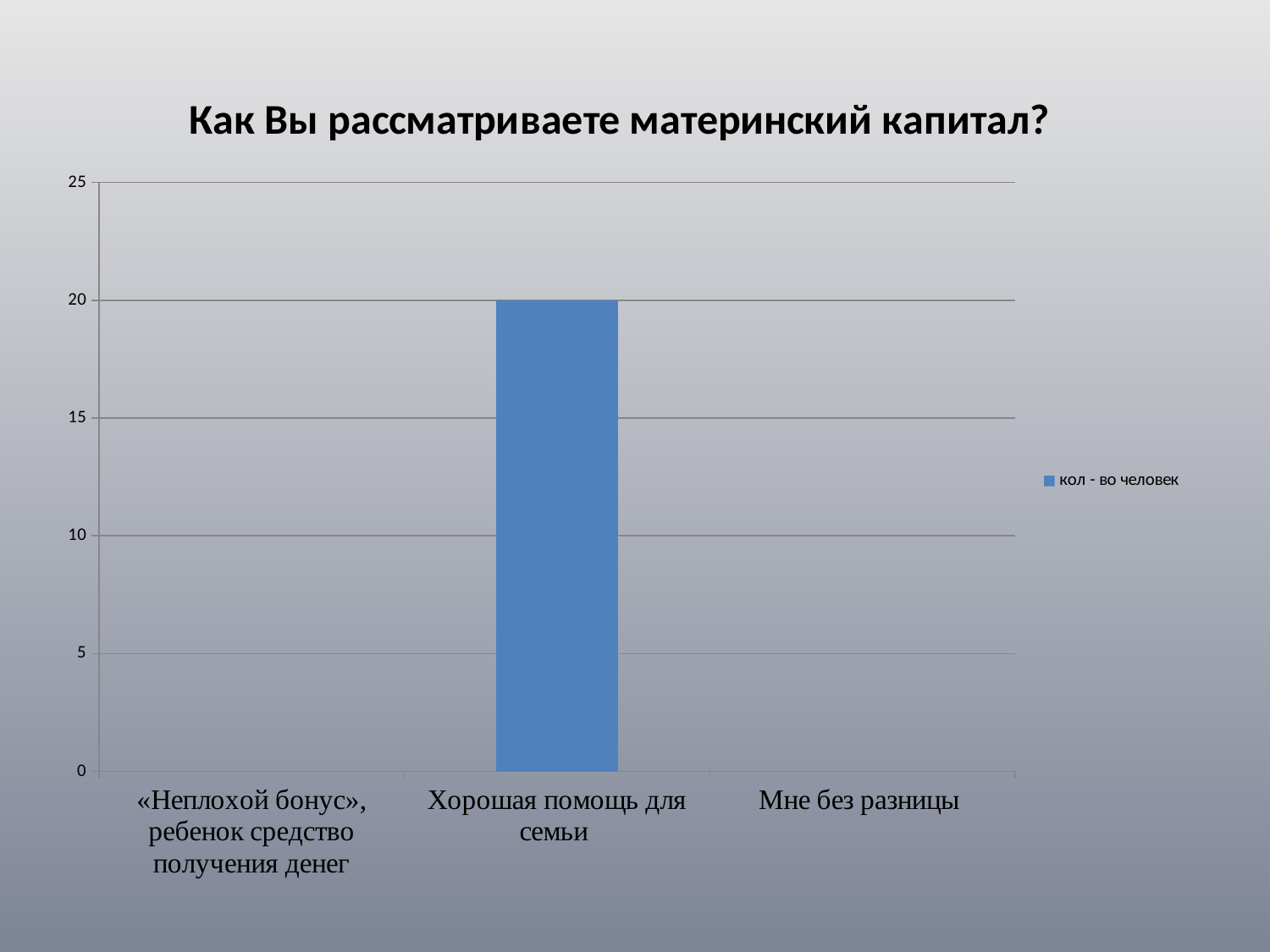
Which category has the highest value? Хорошая помощь для семьи Which is larger: the value for "«Неплохой бонус», ребенок средство получения денег" or the value for "Хорошая помощь для семьи"? Хорошая помощь для семьи Is the value for "Хорошая помощь для семьи" greater or less than 15? greater Is the value for "«Неплохой бонус», ребенок средство получения денег" greater or less than 5? less What kind of chart is shown on the slide? bar chart What is the title of the chart? Как Вы рассматриваете материнский капитал? Is the value for "Мне без разницы" greater or less than 5? less What is the name of the series shown in the legend? кол - во человек Which is larger: the value for "Хорошая помощь для семьи" or the value for "Мне без разницы"? Хорошая помощь для семьи How many series does the legend list? 1 What is the value for "Хорошая помощь для семьи"? 20 How many categories are shown on the x axis of the chart? 3